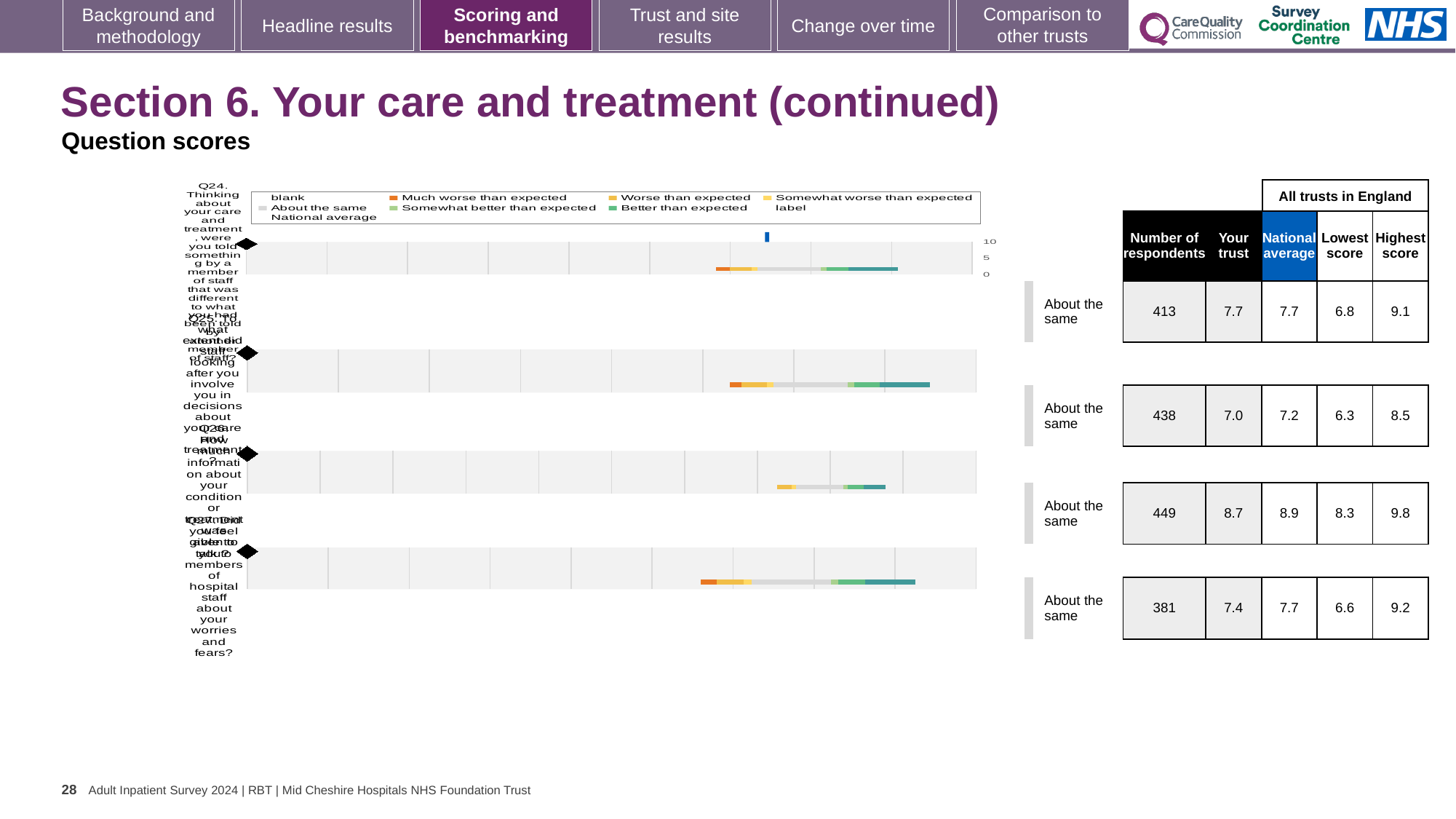
In the table beside the chart, what is the number of respondents for the second row (Q25)? 438 Which legend entry is shown in orange-red in the chart legend? Much worse than expected How many question rows (Q24 to Q27) are plotted in the chart? 4 In the table beside the chart, what is the national average for the fourth row (Q27)? 7.7 In the table beside the chart, what is the 'Your trust' score for the first row (Q24)? 7.7 Which question row has the highest 'Your trust' score in the table beside the chart? Q26 What benchmark category is shown next to every question row in the chart? About the same Which question row has the lowest number of respondents in the table beside the chart? Q27 What is the difference between the national average and the 'Your trust' score for Q27? 0.3 Is the 'Your trust' score for Q25 larger or smaller than the 'Your trust' score for Q24? smaller In the table beside the chart, what is the highest score for the third row (Q26)? 9.8 What kind of chart is shown on the slide? bar chart